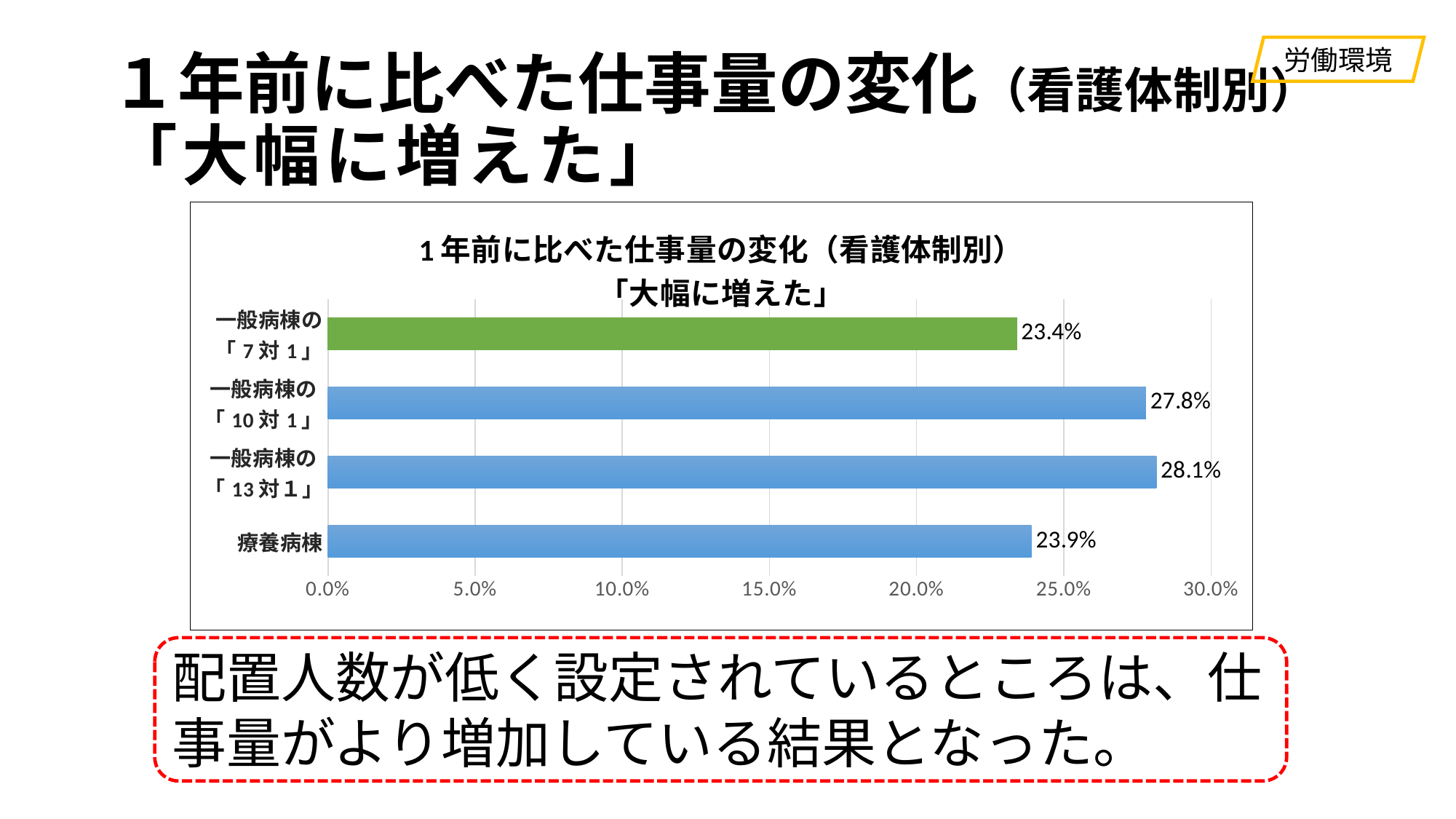
What is the value for 療養病棟? 23.9% Which category has the highest value? 一般病棟の「13対1」 What is the value for 一般病棟の「13対1」? 28.1% Which category has the lowest value? 一般病棟の「7対1」 Which is larger, the value for 一般病棟の「10対1」 or the value for 療養病棟? 一般病棟の「10対1」 What is the value for 一般病棟の「7対1」? 23.4% How many categories are shown in the chart? 4 Is the value for 療養病棟 greater or less than 20.0%? greater What kind of chart is shown on the slide? bar chart What is the value for 一般病棟の「10対1」? 27.8% Which category's bar is coloured green rather than blue? 一般病棟の「7対1」 What is the difference between the values for 一般病棟の「13対1」 and 一般病棟の「7対1」? 4.7 percentage points